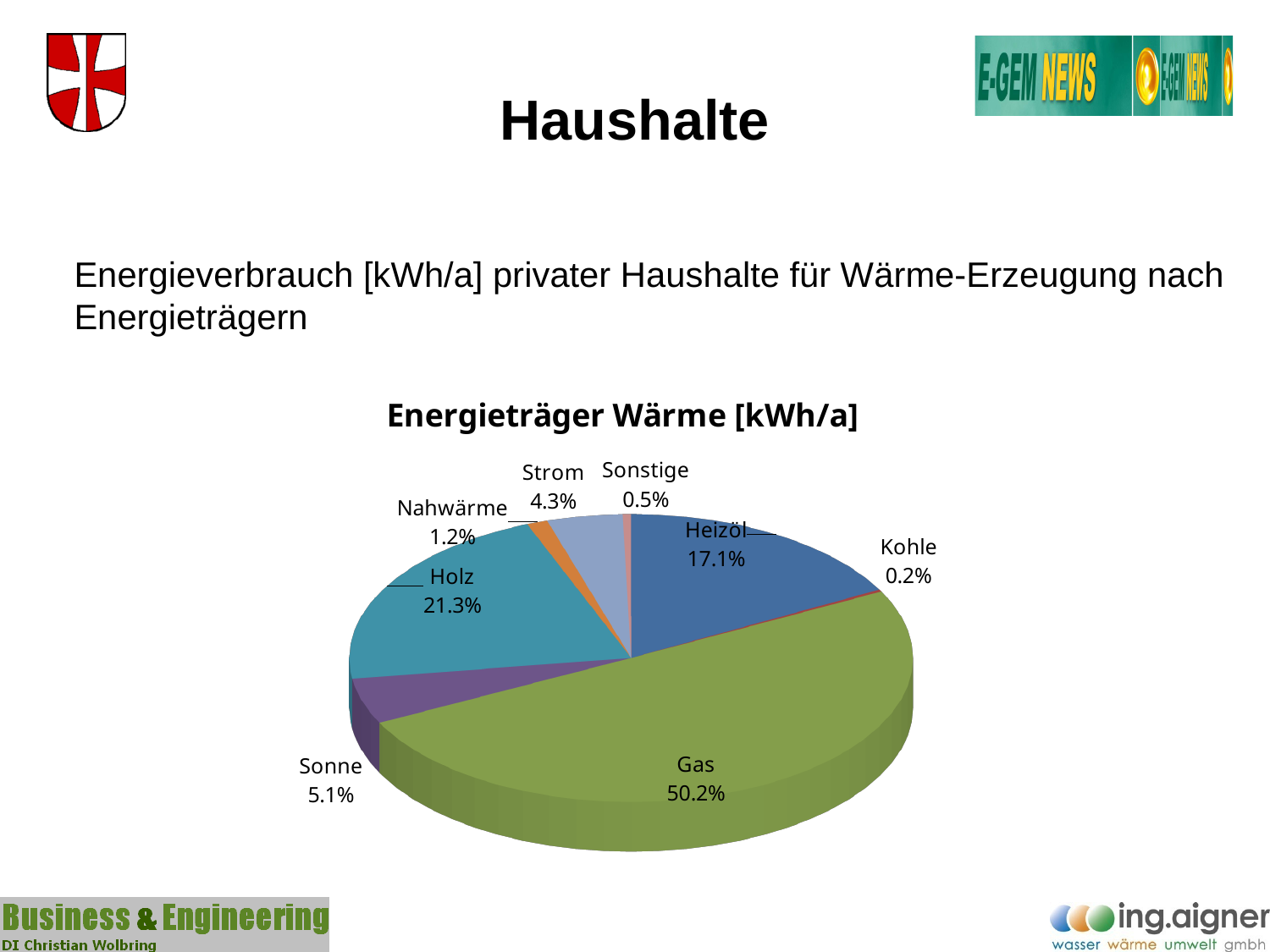
What share of the pie does Heizöl have? 17.1% What share of the pie does Holz have? 21.3% How many slices does the pie chart have? 8 Which has a larger share, Heizöl or Holz? Holz What is the difference in percentage points between the shares of Gas and Holz? 28.9 What kind of chart is shown on the slide? pie chart What share of the pie does Strom have? 4.3% Which energy source has the largest share of the pie? Gas What share of the pie does Gas have? 50.2% What is the title of the chart? Energieträger Wärme [kWh/a] Which energy source has the smallest share of the pie? Kohle What share of the pie does Sonne have? 5.1%